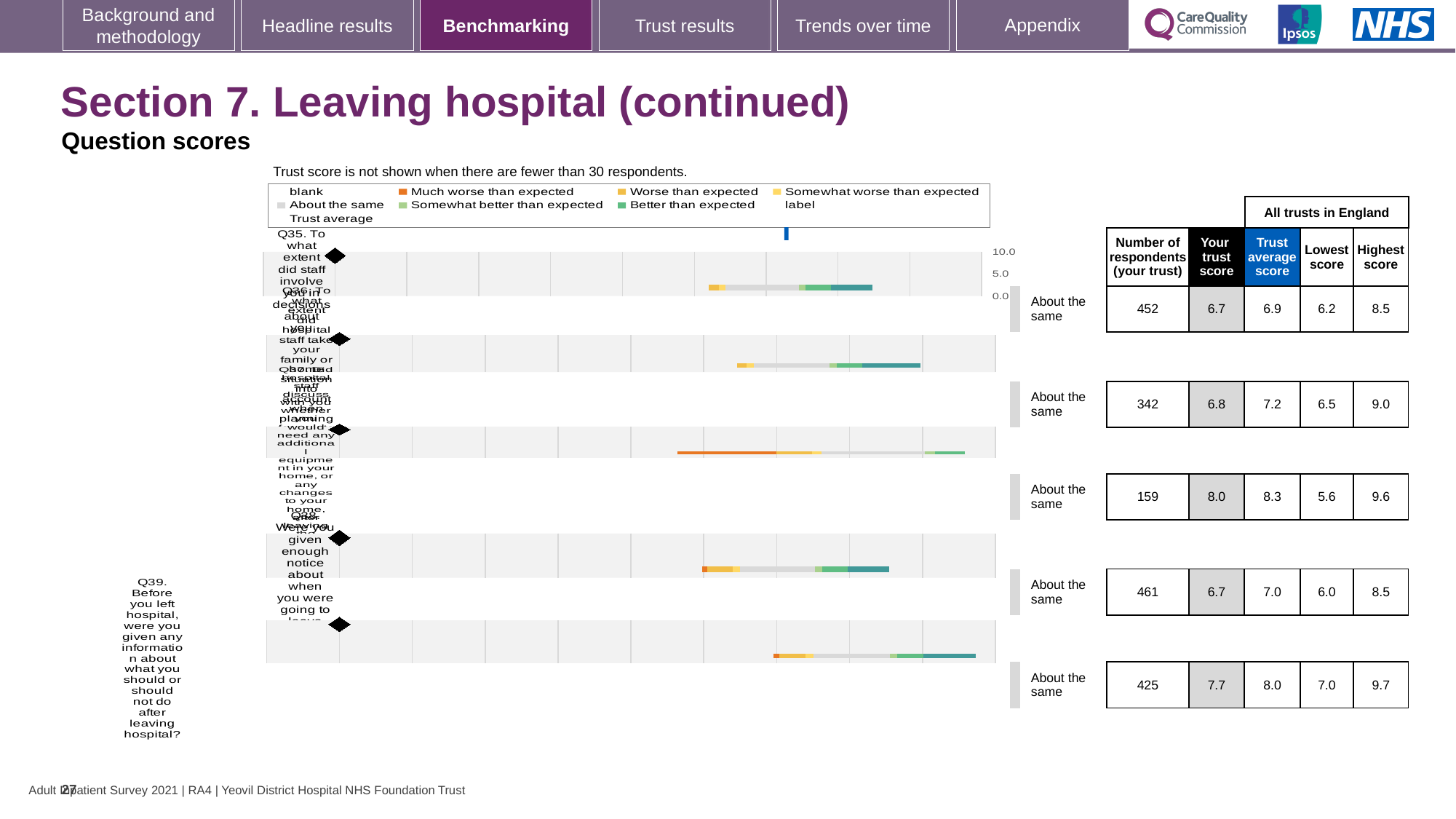
What is the lowest score for the row with 159 respondents? 5.6 What colour does the legend use for 'Much worse than expected'? Orange Which row has the lowest number of respondents (your trust)? The row with 159 respondents What benchmark category is shown for Q35? About the same Which question has the highest number of respondents (your trust)? Q38 What is the highest score across all trusts in England for Q39? 9.7 What is the difference between the trust average score and your trust score for Q39? 0.3 What is the trust average score for Q36? 7.2 What is your trust score for Q38? 6.7 What is the number of respondents (your trust) for Q35? 452 Is your trust score for Q36 higher or lower than the trust average score for Q36? lower How many question rows are shown in the table? 5